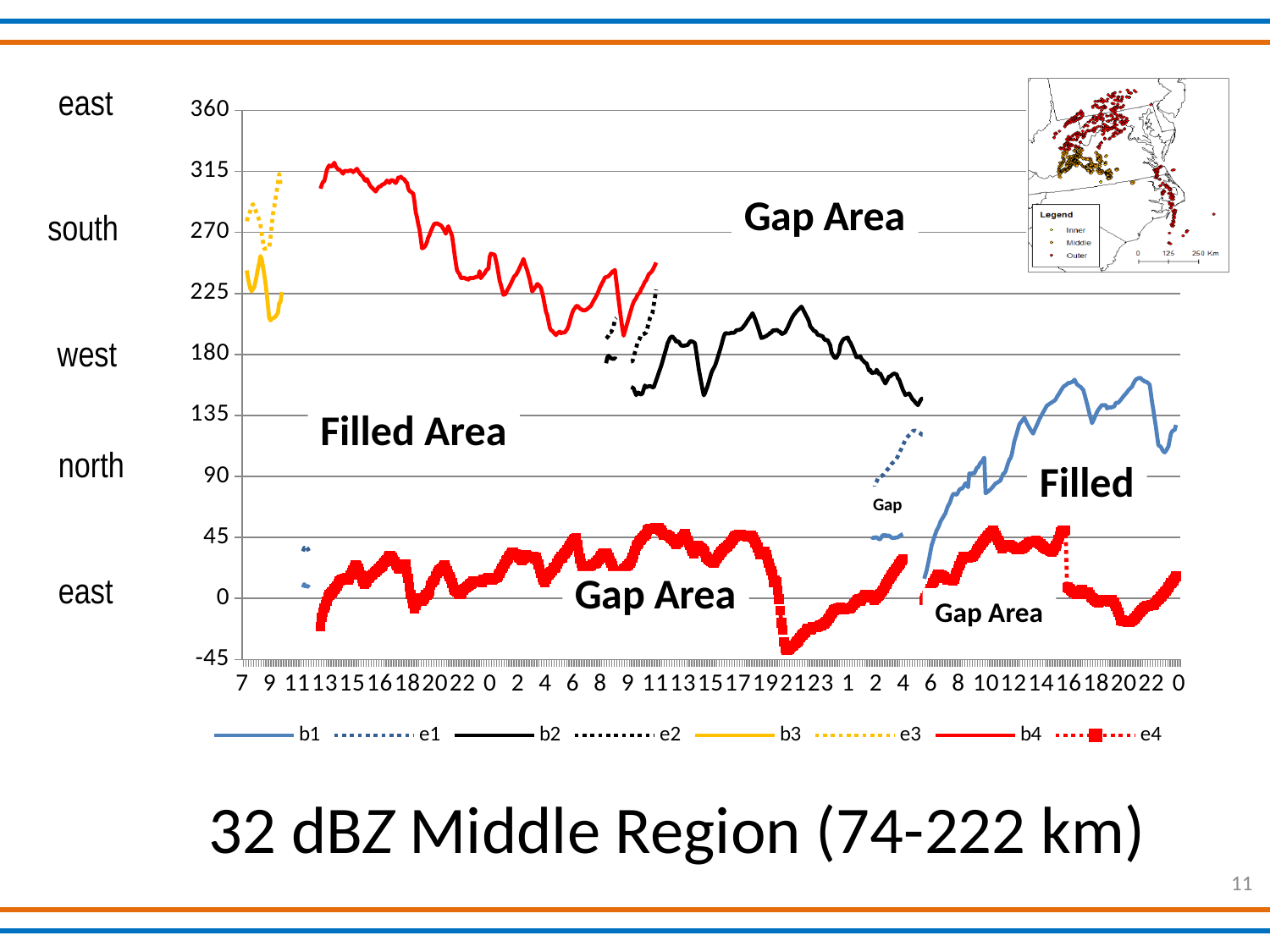
Is the lowest value of the b3 line greater or less than 180? greater Which series reaches a higher peak value, b4 or b2? b4 How many series does the chart legend list? 8 Does the b4 line overall rise or fall from left to right? fall Is the lowest value reached by the e4 series greater or less than 0? less What is the title printed below the chart? 32 dBZ Middle Region (74-222 km) Does the b1 line overall rise or fall from left to right? rise Is the highest value reached by the b4 line greater or less than 270? greater What colour is the b4 series line in the chart? red Which series reaches a higher peak value, b1 or e4? b1 What kind of chart is shown on the slide? line chart